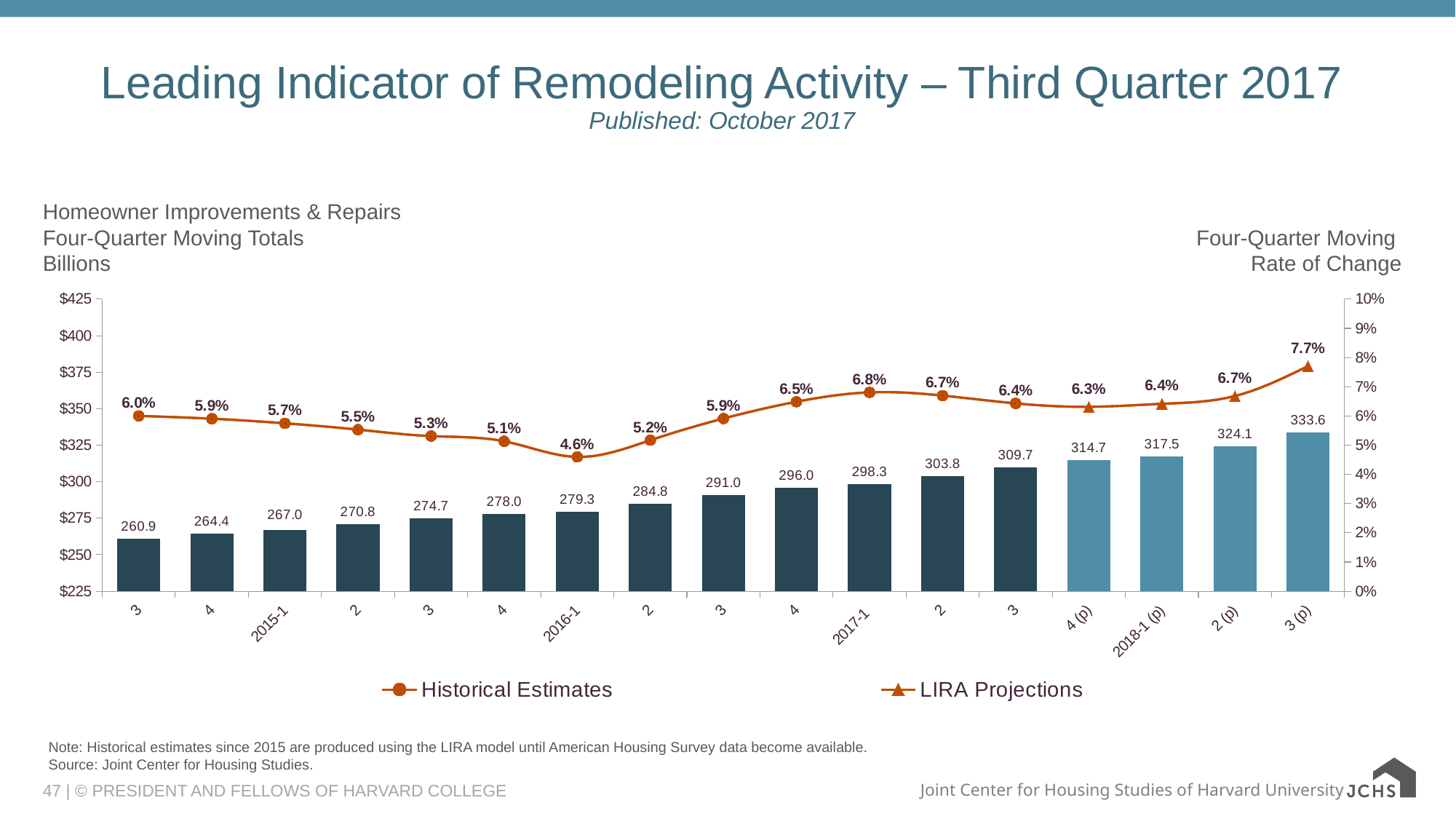
Which quarter has the highest four-quarter moving rate of change? 3 (p) What is the LIRA projected rate of change for 2018-1 (p)? 6.4% Do the four-quarter moving totals (bars) rise or fall from left to right along the x axis? rise Which quarter has the lowest four-quarter moving rate of change? 2016-1 What is the four-quarter moving total (in billions) for 2017-1? 298.3 What is the projected four-quarter moving total for 3 (p)? 333.6 What is the difference between the four-quarter moving totals for 2 (p) and 2018-1 (p)? 6.6 Is the four-quarter moving total for 4 (p) greater or less than $300? greater Which is larger, the rate of change for 2017-1 or for 2015-1? 2017-1 How many quarters are shown on the x axis? 17 What is the four-quarter moving rate of change for 2016-1? 4.6% How many series does the legend list? 2